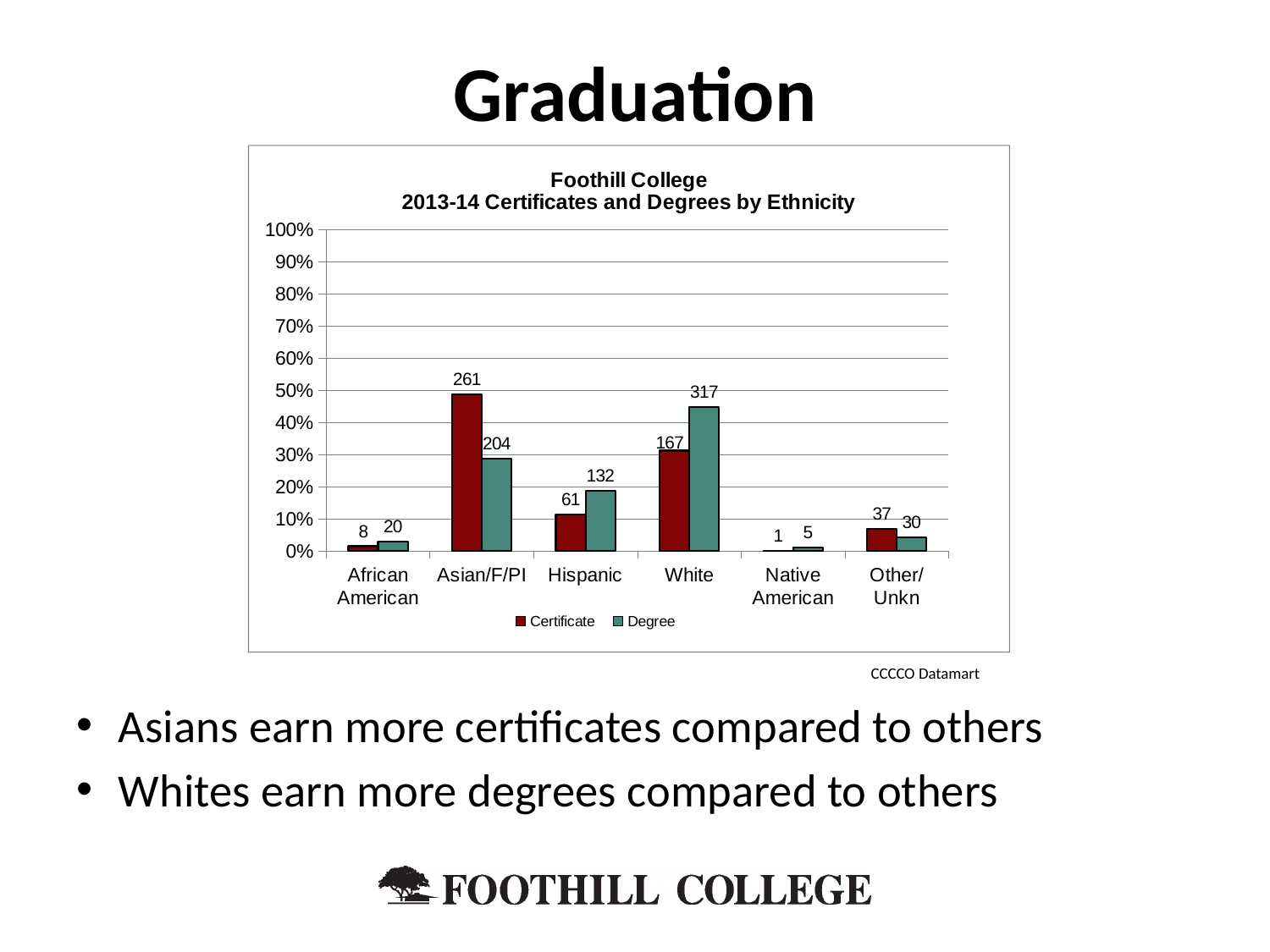
What is the data label on the Degree bar for White? 317 What is the data label on the Certificate bar for Native American? 1 What is the data label on the Certificate bar for Asian/F/PI? 261 What is the data label on the Degree bar for Hispanic? 132 Which is larger for Other/Unkn, the Certificate value or the Degree value? Certificate How many ethnicity categories are shown on the x axis? 6 How many series does the legend list? 2 What type of chart is shown on the slide? Bar chart Which ethnicity has the lowest Degree value? Native American What is the difference between the Degree and Certificate labels for White? 150 Which ethnicity has the highest Certificate value? Asian/F/PI Is the Degree bar for White greater or less than 40% on the axis? greater